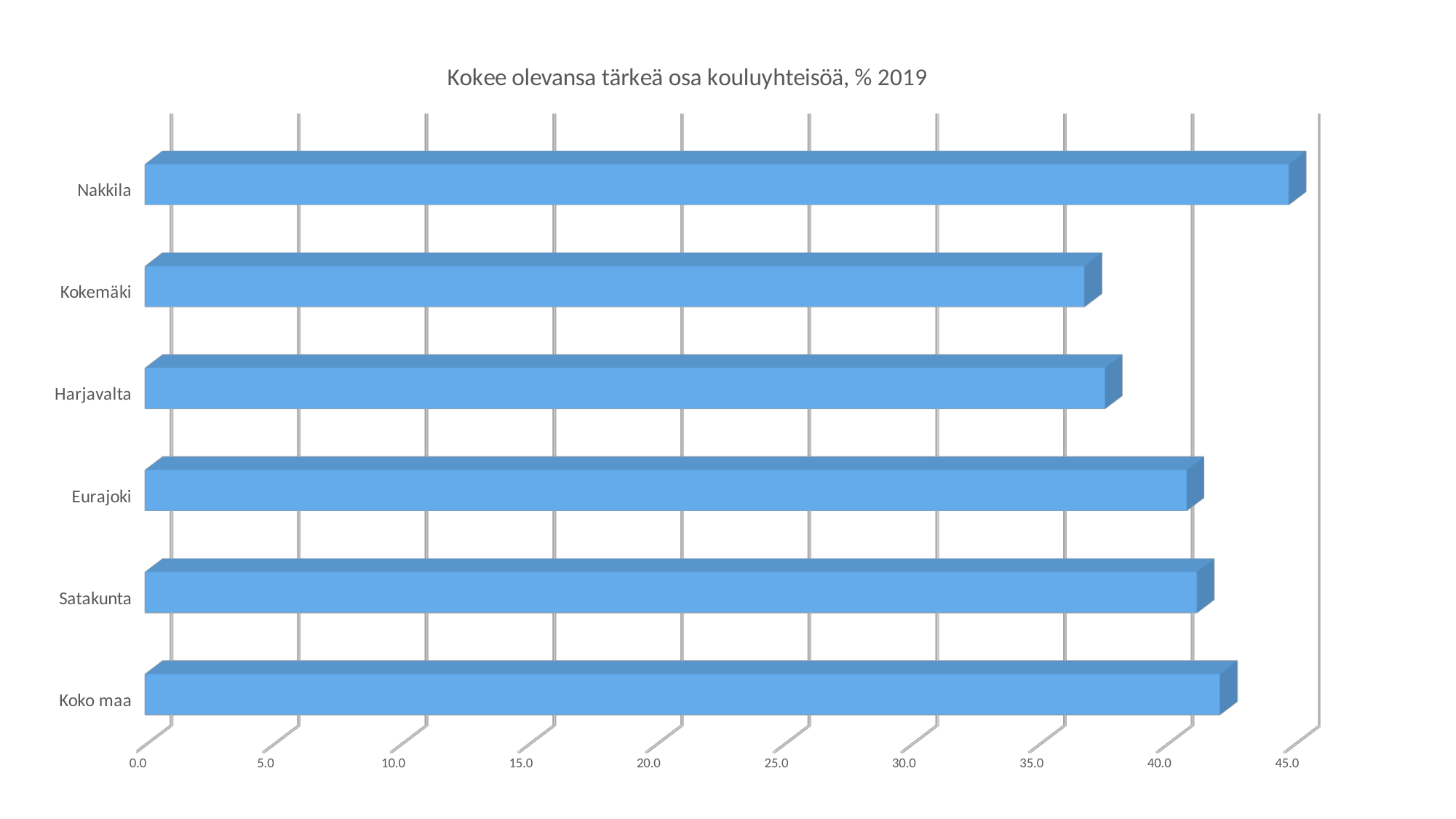
How many categories are shown in the chart? 6 What is the title of the chart? Kokee olevansa tärkeä osa kouluyhteisöä, % 2019 Is the value for Kokemäki greater or less than 40? less What kind of chart is shown on the slide? bar chart Is the value for Nakkila greater or less than 40? greater Is the value for Harjavalta greater or less than 35? greater Which is larger, the value for Koko maa or the value for Harjavalta? Koko maa What is the highest value labelled on the horizontal axis? 45.0 Which category has the highest value? Nakkila Which is larger, the value for Nakkila or the value for Kokemäki? Nakkila